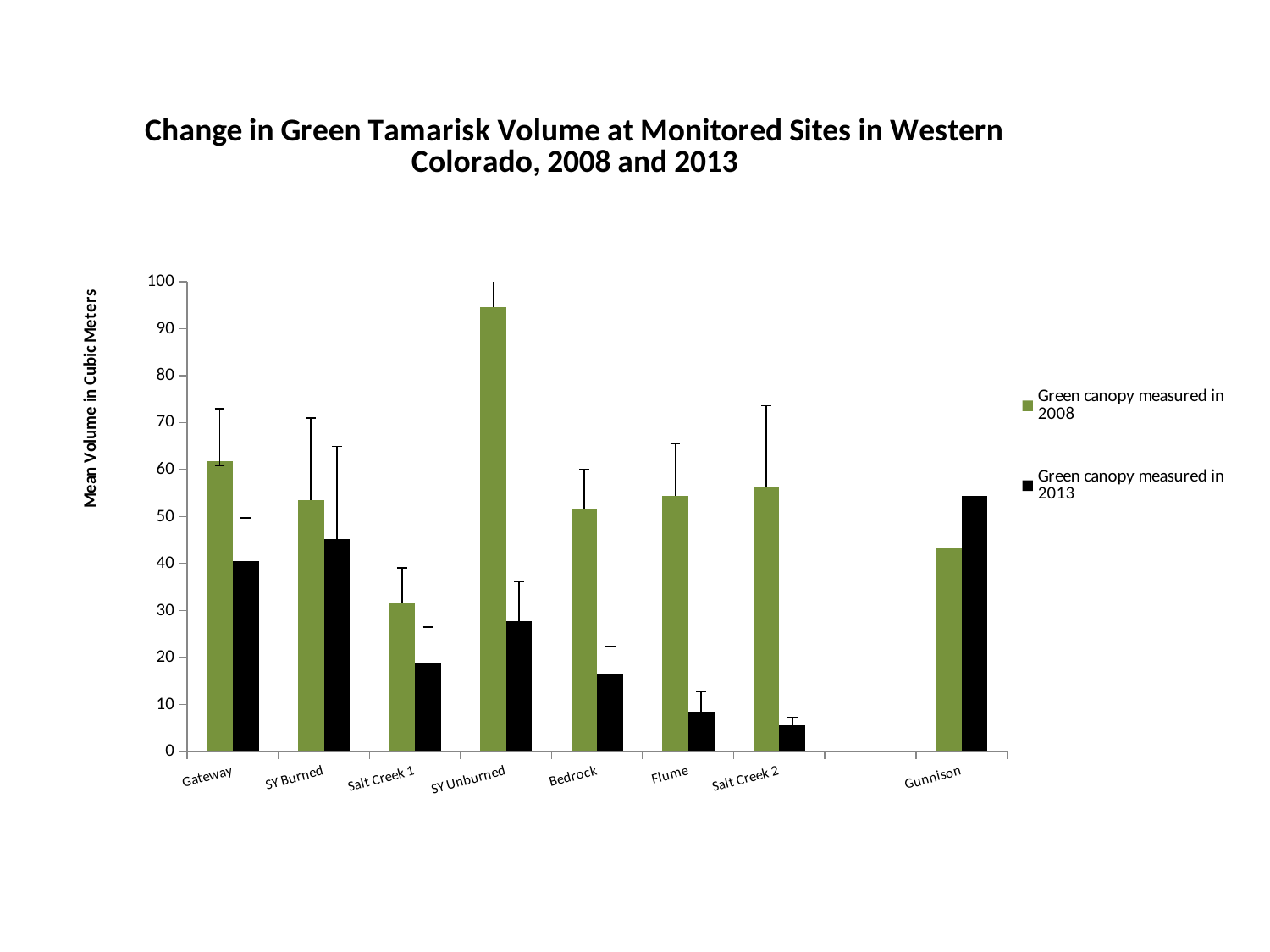
Which site has the lowest green canopy measured in 2008? Salt Creek 1 Is the green canopy measured in 2008 at SY Unburned greater or less than 90? greater What kind of chart is shown on the slide? bar chart Is the green canopy measured in 2013 at Gunnison greater or less than 50? greater Which site has the highest green canopy measured in 2008? SY Unburned Which site has the highest green canopy measured in 2013? Gunnison How many series does the legend list? 2 What is the label of the y axis? Mean Volume in Cubic Meters Which site has the lowest green canopy measured in 2013? Salt Creek 2 Is the green canopy measured in 2013 at Flume greater or less than 10? less How many sites are labeled on the x axis? 8 At Gunnison, which is larger: the green canopy measured in 2008 or in 2013? 2013